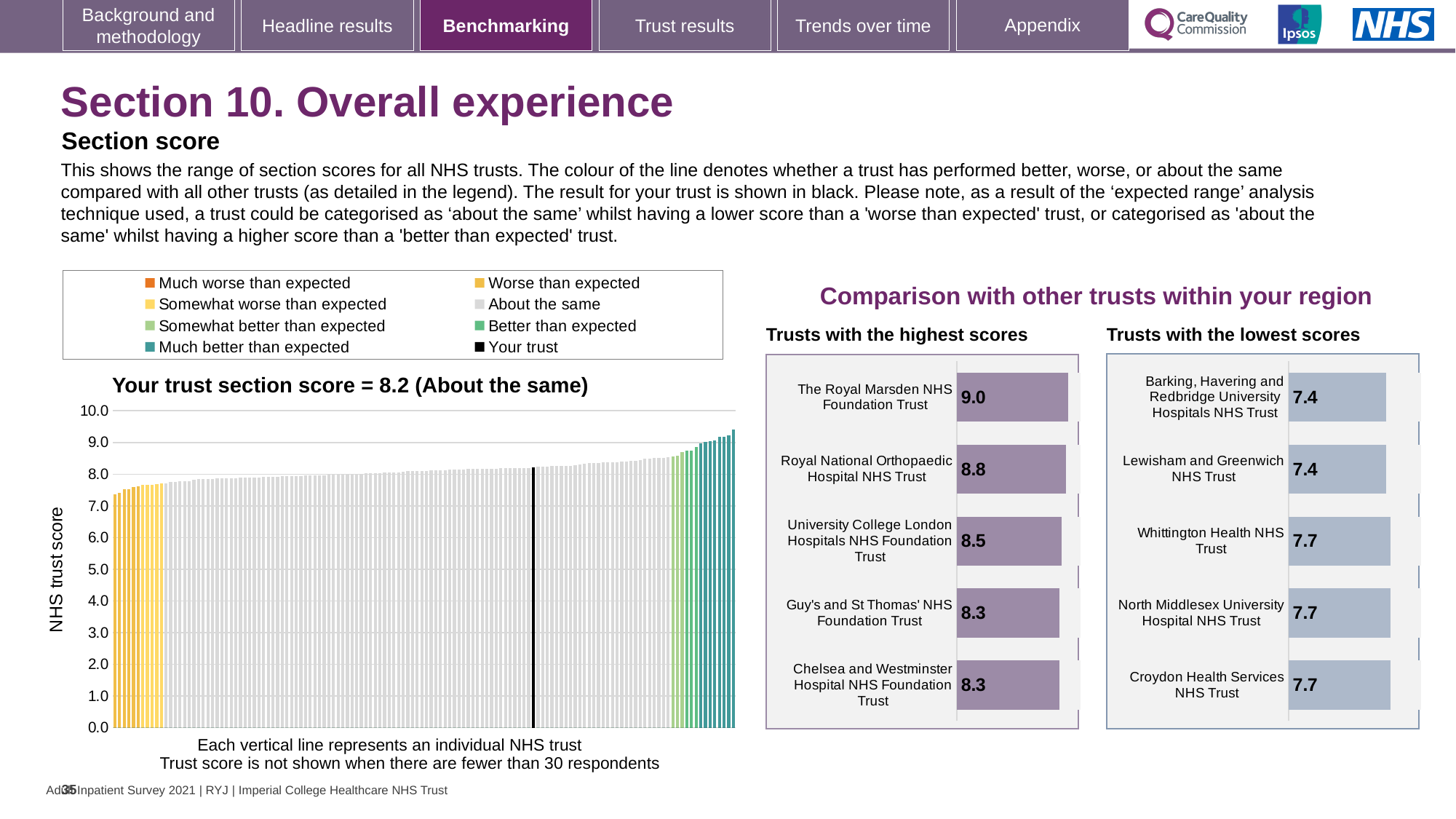
How many entries does the legend above the main 'Your trust section score' chart list? 8 In the 'Trusts with the highest scores' chart, which trust has the highest score? The Royal Marsden NHS Foundation Trust In the main 'Your trust section score' chart, what is the section score for your trust? 8.2 In the 'Trusts with the highest scores' chart, what is the difference between the scores of The Royal Marsden NHS Foundation Trust and Guy's and St Thomas' NHS Foundation Trust? 0.7 In the 'Trusts with the lowest scores' chart, which has the higher score: Lewisham and Greenwich NHS Trust or Croydon Health Services NHS Trust? Croydon Health Services NHS Trust In the main 'Your trust section score' chart, is the lowest trust score greater or less than 7.0? greater In the 'Trusts with the lowest scores' chart, what is the score for Barking, Havering and Redbridge University Hospitals NHS Trust? 7.4 In the 'Trusts with the highest scores' chart, what is the score for The Royal Marsden NHS Foundation Trust? 9.0 In the 'Trusts with the lowest scores' chart, what is the difference between the scores of Croydon Health Services NHS Trust and Barking, Havering and Redbridge University Hospitals NHS Trust? 0.3 How many trusts are shown in the 'Trusts with the highest scores' chart? 5 In the 'Trusts with the highest scores' chart, what is the score for University College London Hospitals NHS Foundation Trust? 8.5 In the 'Trusts with the lowest scores' chart, what is the score for Whittington Health NHS Trust? 7.7